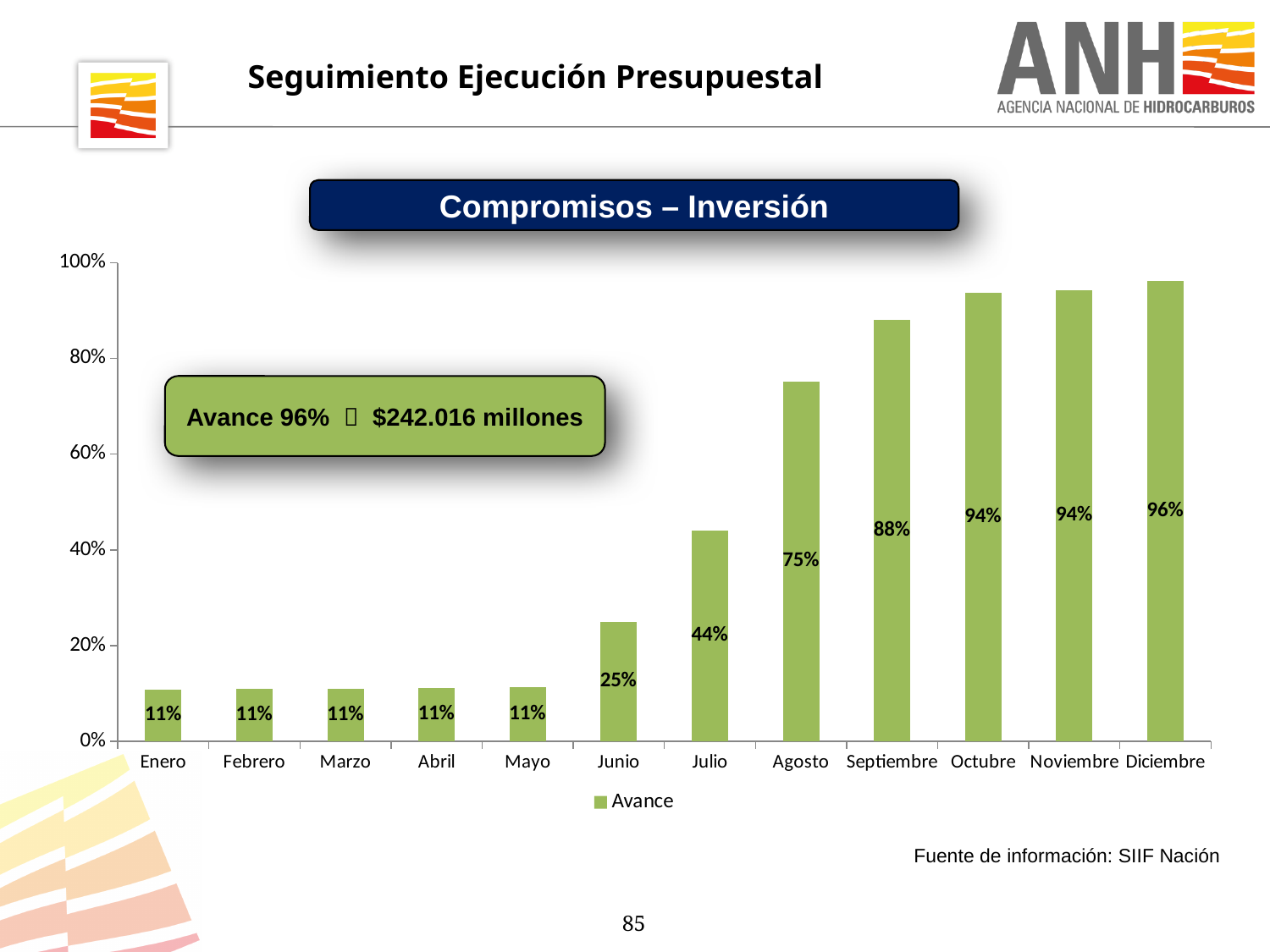
How many months are shown on the x axis? 12 Is the value for Julio greater or less than 40%? greater What is the difference between the values for Diciembre and Agosto? 21% Which month has the highest value? Diciembre What is the difference between the values for Julio and Junio? 19% What is the value for Junio? 25% What is the value for Septiembre? 88% What kind of chart is shown? Bar chart How many series does the legend list? 1 Do the values rise or fall from Enero to Diciembre? Rise Which is larger, the value for Julio or the value for Agosto? Agosto What is the value for Agosto? 75%